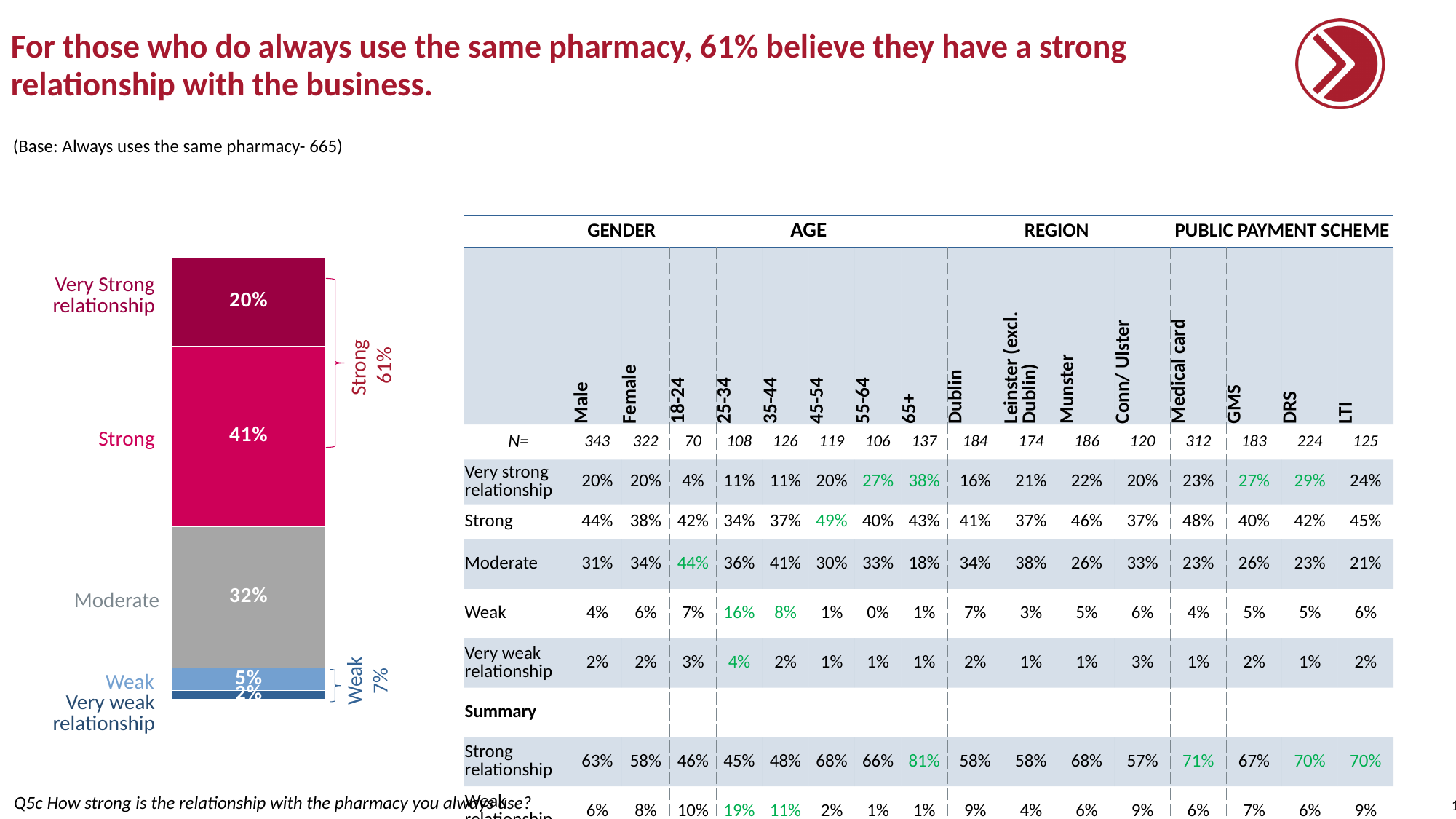
What percentage of respondents say they have a very strong relationship with their pharmacy, according to the stacked bar chart? 20% In the bar chart, which is larger: the Moderate segment or the Very Strong relationship segment? Moderate What percentage is shown for the Moderate segment of the bar chart? 32% What type of chart is shown on the left of the slide? Stacked bar chart What value is shown for the Strong segment of the stacked bar chart? 41% Which segment of the stacked bar chart has the smallest value? Very weak relationship What percentage is shown for the Very weak relationship segment of the bar chart? 2% What combined percentage does the bracket labelled 'Strong' next to the bar chart show? 61% What value is shown for the Weak segment of the bar chart? 5% By how many percentage points does the Strong segment exceed the Very Strong relationship segment in the bar chart? 21 percentage points Which segment of the stacked bar chart has the largest value? Strong How many segments make up the stacked bar in the chart? 5